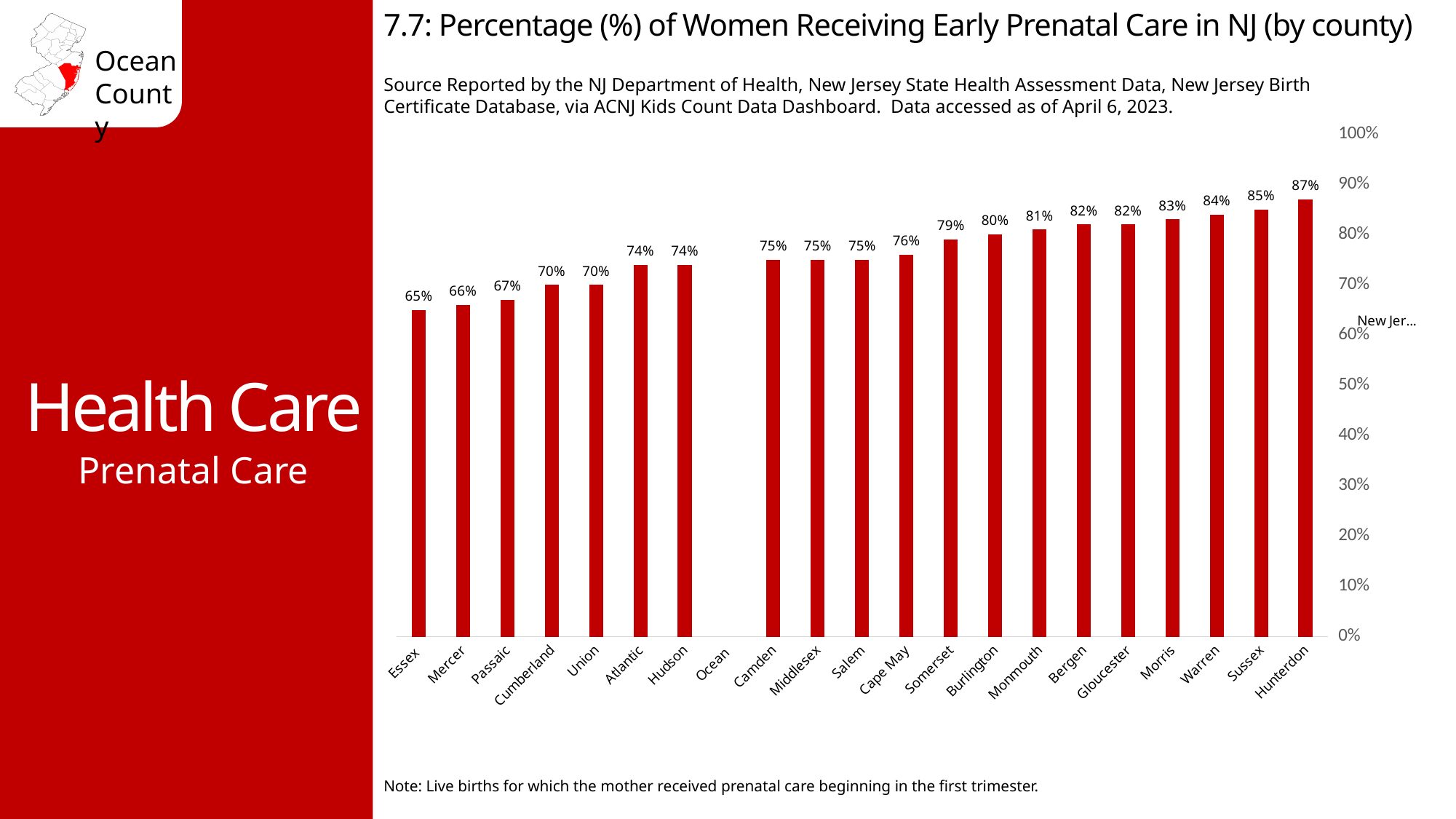
Which county has the lowest percentage of women receiving early prenatal care? Essex Do the values generally rise or fall moving from left to right along the x axis? Rise What is the difference in percentage points between Hunterdon and Essex? 22 What type of chart is shown on the slide? Bar chart What is the percentage of women receiving early prenatal care in Hunterdon county? 87% Is the value for Morris greater or less than 80%? greater What is the value shown for Somerset county? 79% Which county on the x axis has no bar plotted? Ocean How many county labels are listed along the x axis? 21 Which county has the highest percentage of women receiving early prenatal care? Hunterdon Which county has a higher value, Bergen or Somerset? Bergen What is the value shown for Cumberland county? 70%